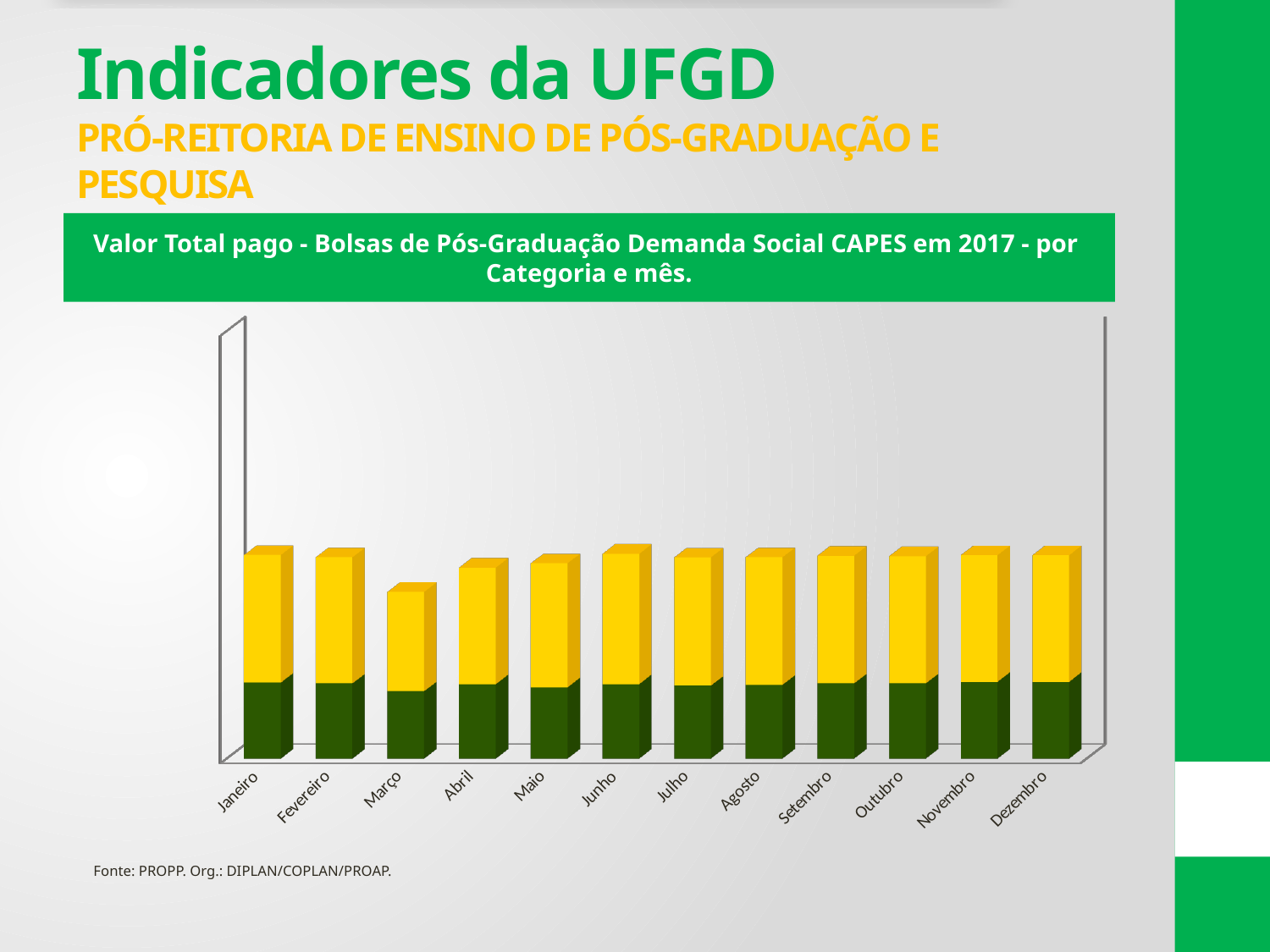
Which has the larger total bar, Janeiro or Março? Janeiro Which has the larger total bar, Março or Dezembro? Dezembro What is the first month shown on the x axis of the chart? Janeiro What kind of chart is shown on the slide? Stacked bar chart How many months are shown on the x axis of the chart? 12 What is the last month shown on the x axis of the chart? Dezembro What two colours are used for the segments of each stacked bar? Dark green and yellow Which month has the lowest total bar in the chart? Março What is the title of the chart? Valor Total pago - Bolsas de Pós-Graduação Demanda Social CAPES em 2017 - por Categoria e mês. Is the total bar for Março larger or smaller than the total bar for Abril? Smaller